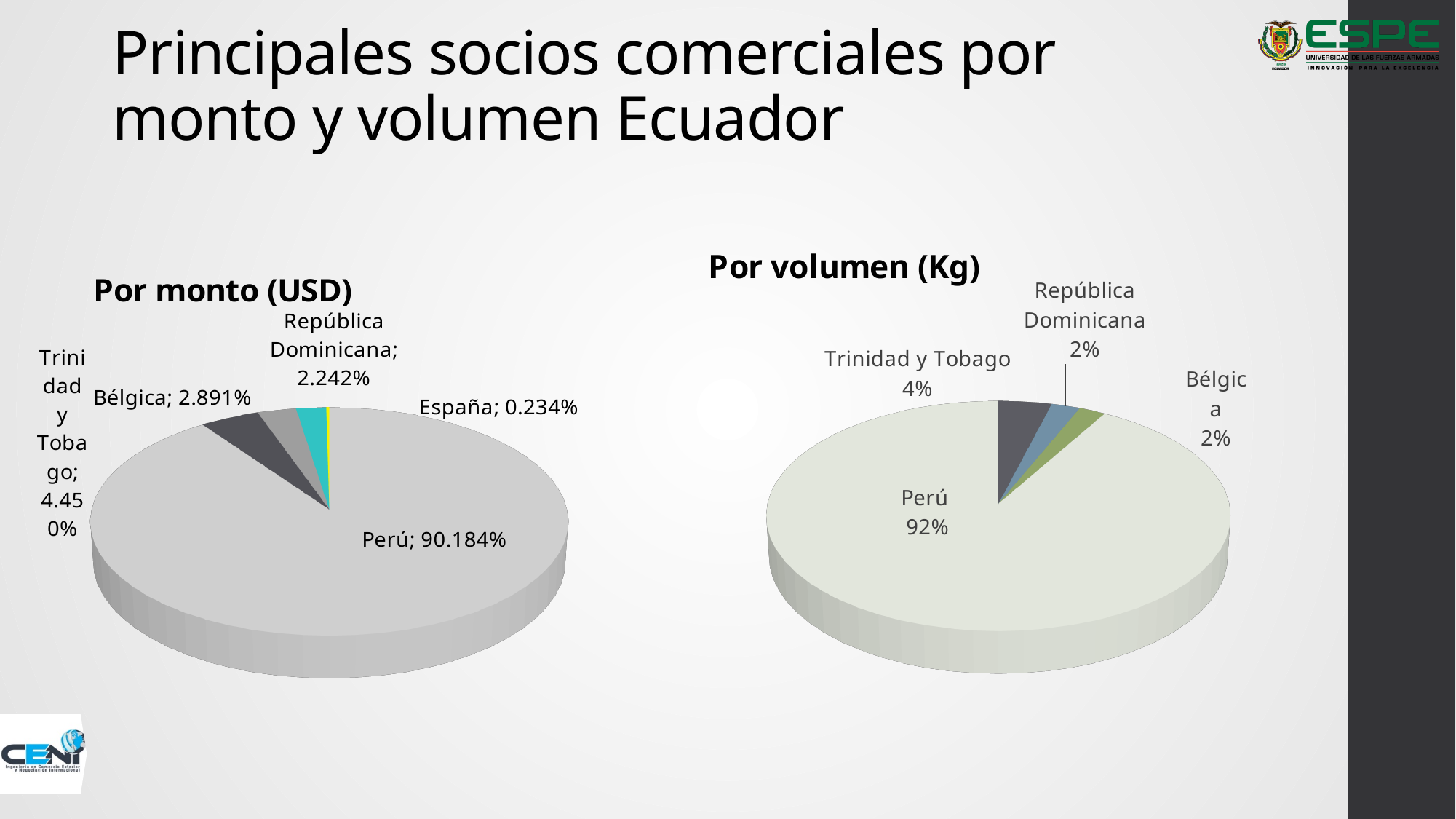
In the 'Por monto (USD)' chart, which is larger, Bélgica or República Dominicana? Bélgica In the 'Por monto (USD)' chart, what share does Trinidad y Tobago have? 4.450% In the 'Por volumen (Kg)' chart, which country has the largest share? Perú In the 'Por monto (USD)' chart, what share does Perú have? 90.184% What type of chart is the 'Por volumen (Kg)' chart? Pie chart In the 'Por monto (USD)' chart, what share does Bélgica have? 2.891% In the 'Por volumen (Kg)' chart, how many countries are shown? 4 In the 'Por monto (USD)' chart, which country has the smallest share? España In the 'Por monto (USD)' chart, what share does España have? 0.234% In the 'Por volumen (Kg)' chart, what share does Perú have? 92% In the 'Por volumen (Kg)' chart, what share does Trinidad y Tobago have? 4% In the 'Por monto (USD)' chart, how many countries are shown? 5